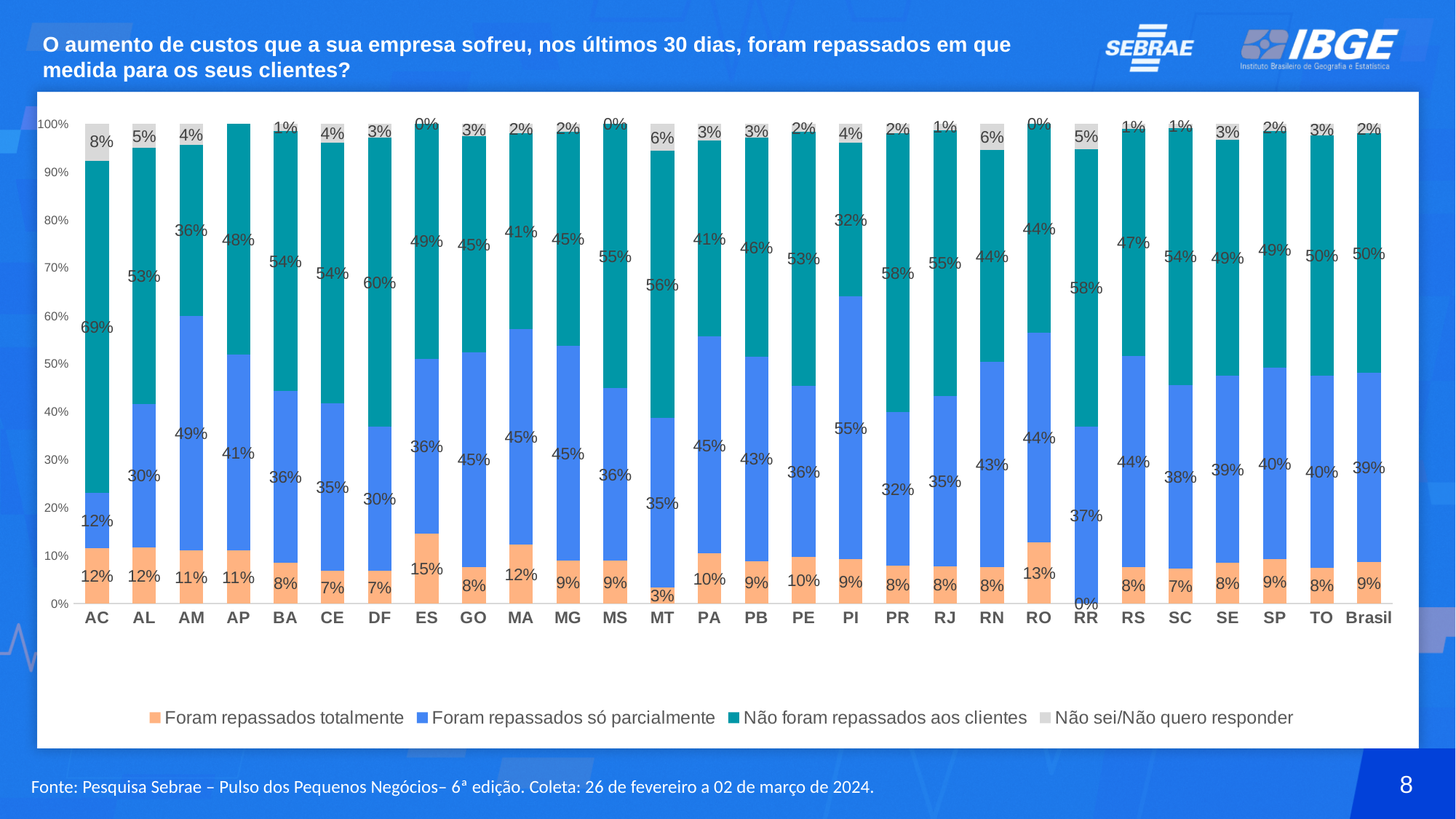
What is the value of 'Foram repassados totalmente' for ES? 15% What is the value of 'Não foram repassados aos clientes' for Brasil? 50% What colour represents 'Foram repassados totalmente' in the chart? orange What is the difference between the 'Não foram repassados aos clientes' values for DF and PI? 28% How many categories are shown along the x axis? 28 What type of chart is shown on the slide? stacked bar chart Which category has the highest value for 'Não foram repassados aos clientes'? AC What is the value of 'Foram repassados só parcialmente' for PI? 55% How many series does the legend list? 4 Which is larger: the 'Foram repassados só parcialmente' value for AM or for AL? AM What is the value of 'Não sei/Não quero responder' for AC? 8% Which category has the lowest value for 'Foram repassados totalmente'? RR